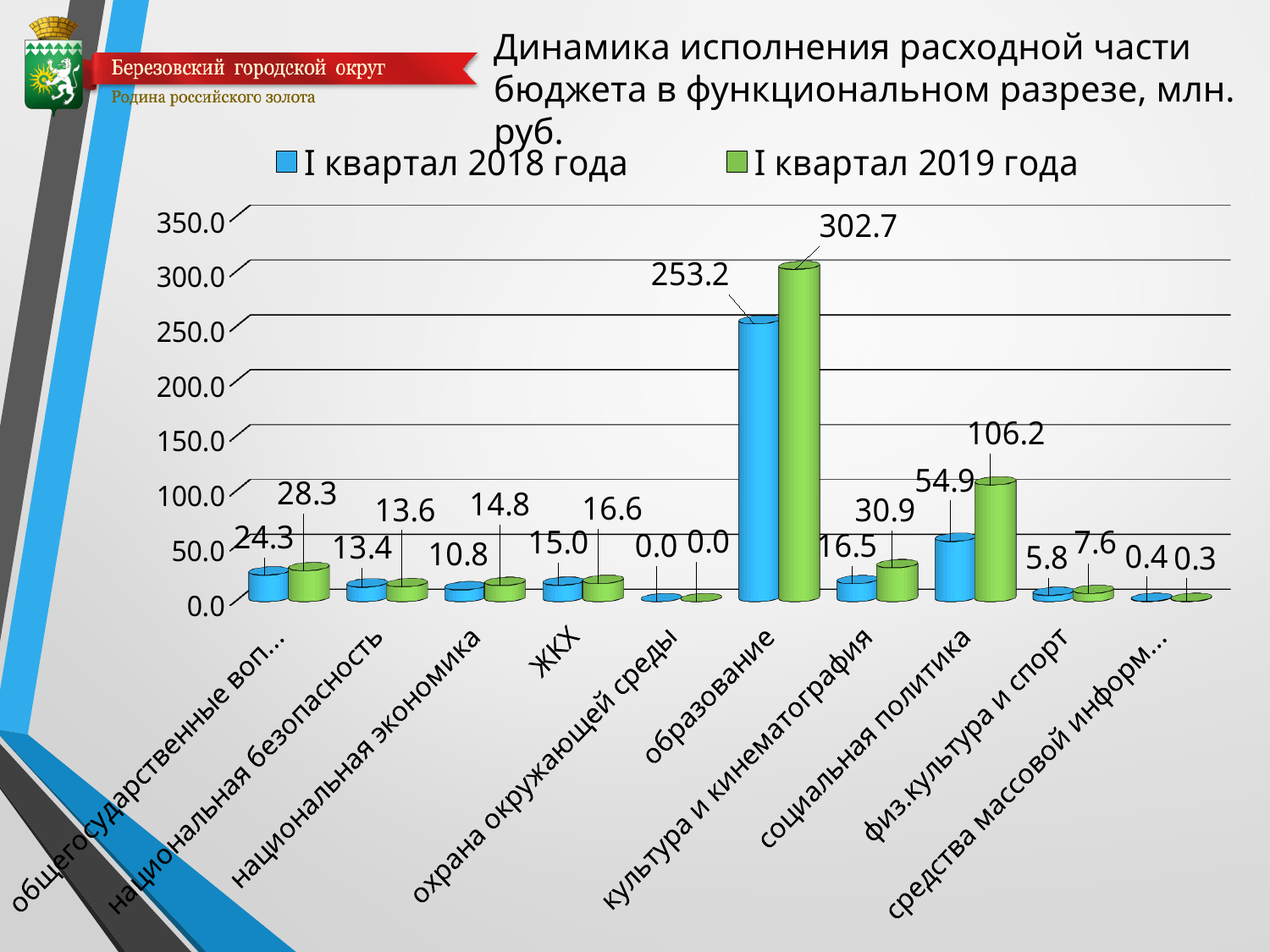
How many series does the legend list? 2 What kind of chart is shown on the slide? bar chart What is the difference between the I квартал 2019 года and I квартал 2018 года values for образование? 49.5 Which category has the highest value in I квартал 2019 года? образование What is the value for ЖКХ in I квартал 2018 года? 15.0 What is the value for культура и кинематография in I квартал 2019 года? 30.9 What is the value for образование in I квартал 2019 года? 302.7 What is the difference between the I квартал 2019 года and I квартал 2018 года values for социальная политика? 51.3 Which is larger for национальная экономика: the I квартал 2018 года value or the I квартал 2019 года value? I квартал 2019 года What is the value for социальная политика in I квартал 2018 года? 54.9 Which category has the lowest value in I квартал 2018 года? охрана окружающей среды How many categories are shown on the x axis? 10